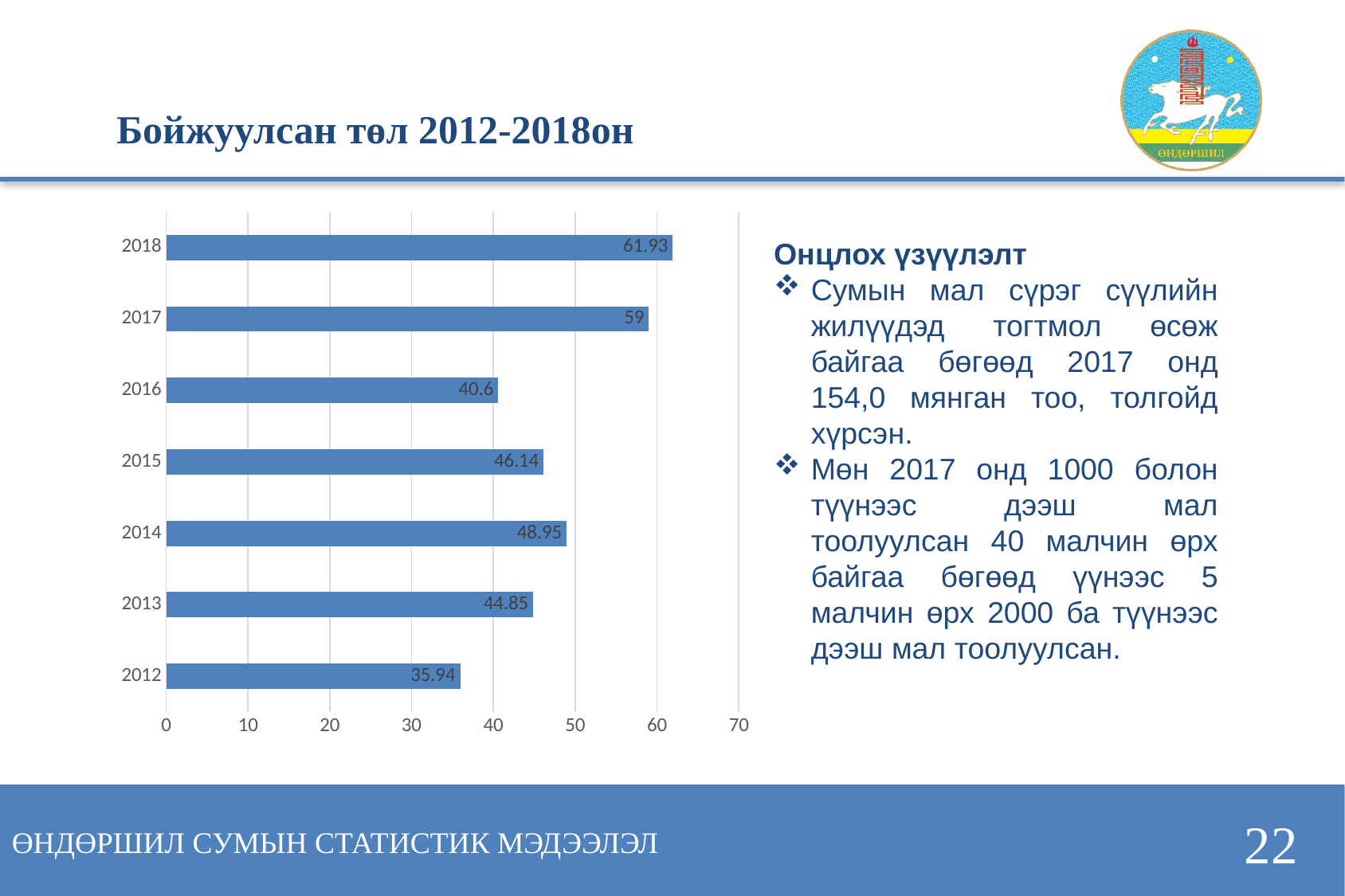
What kind of chart is shown on the slide? bar chart What is the value for 2018? 61.93 How many years are shown in the chart? 7 Which is larger, the value for 2014 or the value for 2015? 2014 Is the value for 2013 greater or less than 40? greater What is the difference between the values for 2016 and 2012? 4.66 What is the value for 2012? 35.94 Which year has the lowest value? 2012 What is the title of the slide containing the chart? Бойжуулсан төл 2012-2018он Which year has the highest value? 2018 What is the value for 2016? 40.6 What is the difference between the values for 2018 and 2017? 2.93